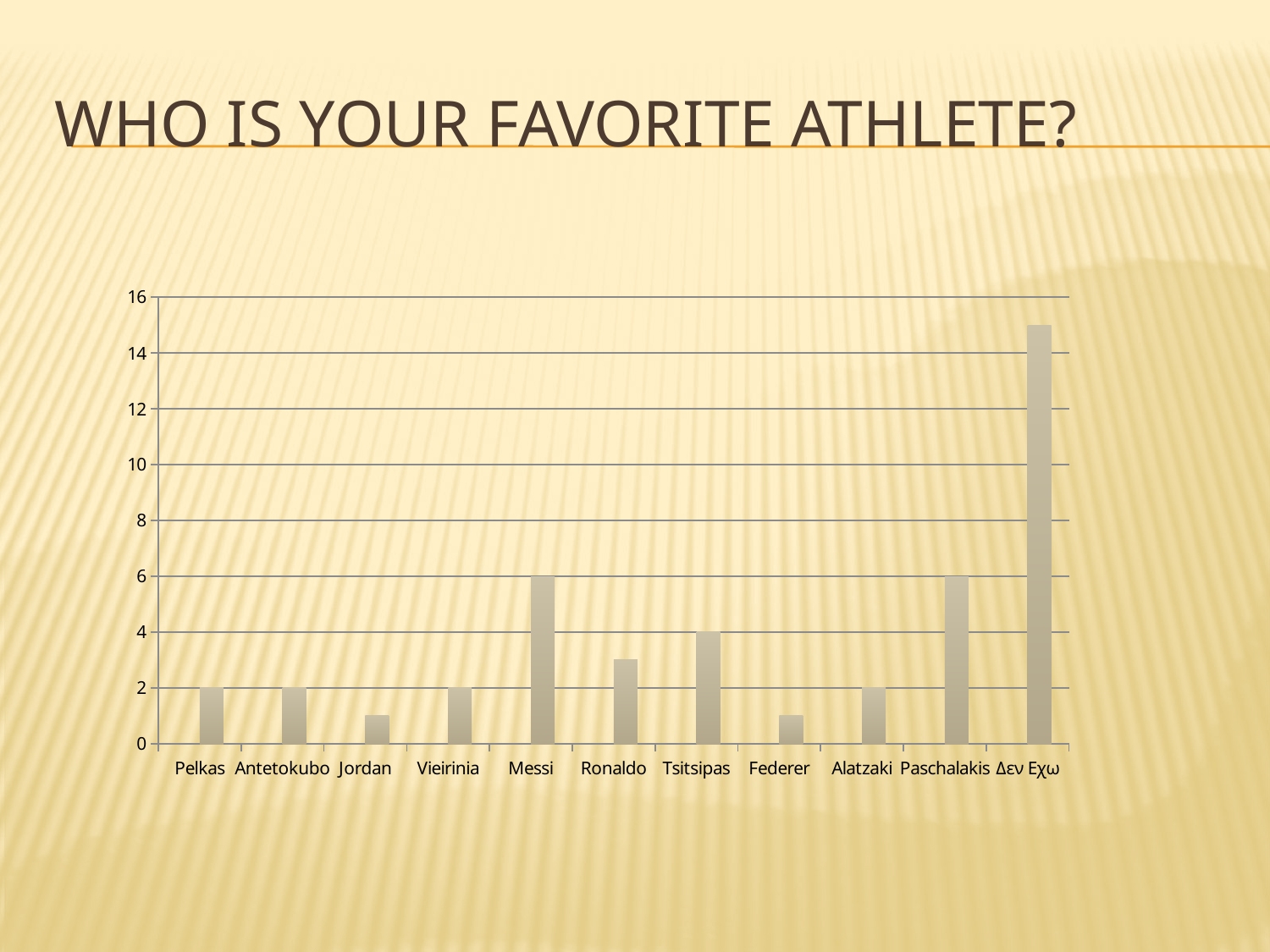
What is the value for Paschalakis? 6 What is the difference between the values for Messi and Tsitsipas? 2 What kind of chart is shown on the slide? bar chart What is the value for Tsitsipas? 4 What is the title of the chart on the slide? WHO IS YOUR FAVORITE ATHLETE? What is the value for Messi? 6 Which is larger, the value for Messi or the value for Ronaldo? Messi What is the value for Pelkas? 2 How many categories are shown on the x axis of the chart? 11 Is the value for Δεν Εχω greater or less than 14? greater Which category has the highest bar? Δεν Εχω Is the value for Jordan greater or less than 2? less